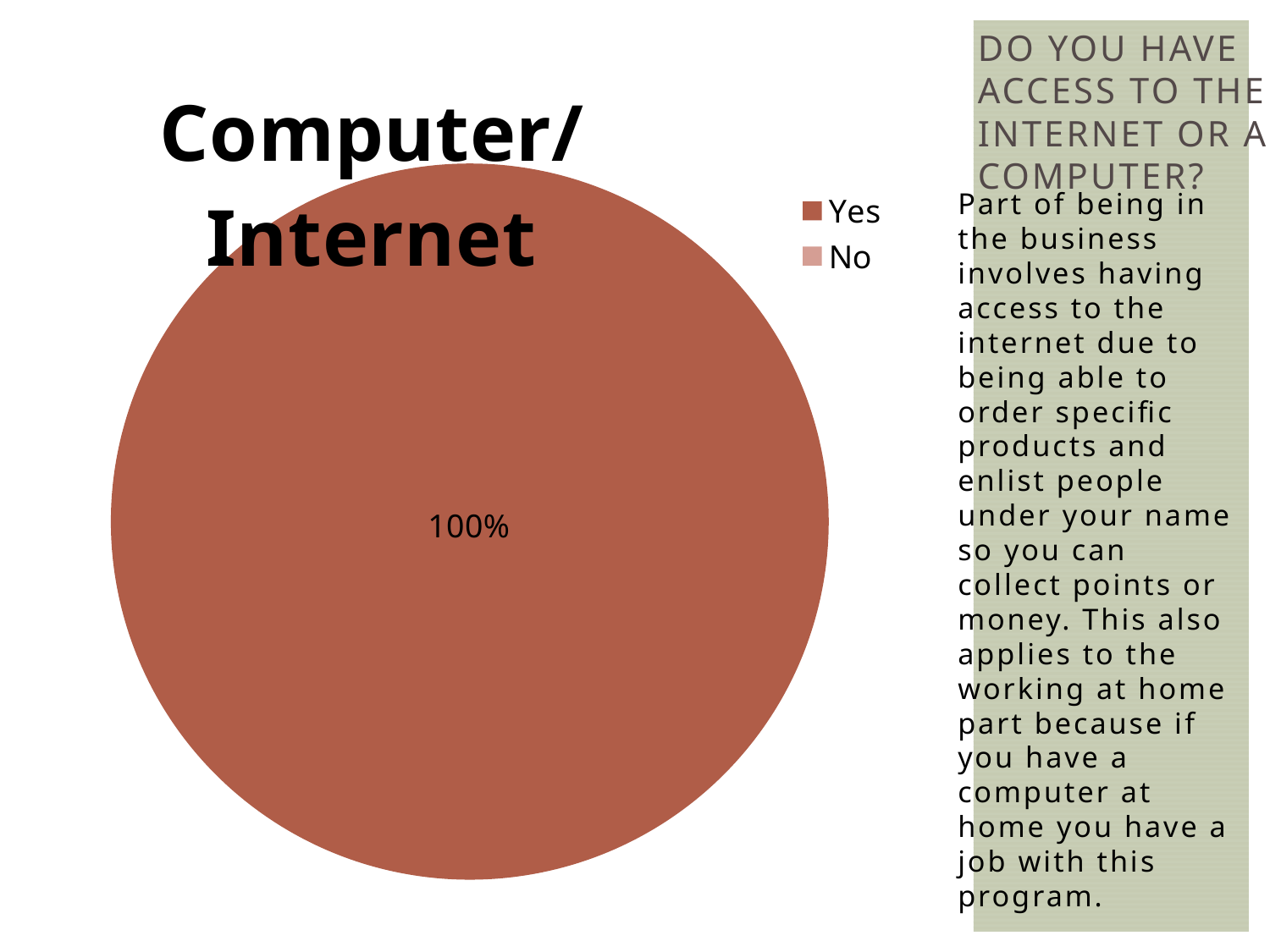
Which category has the smallest share of the pie? No What share of the pie does the "Yes" slice take? 100% What kind of chart is shown on the slide? pie chart How many entries does the chart legend list? 2 Which is larger, the share for "Yes" or the share for "No"? Yes Which category has the largest share of the pie? Yes What percentage label is printed on the pie? 100% What is the title of the chart? Computer/ Internet Which legend entry is shown in the darker red-brown colour? Yes